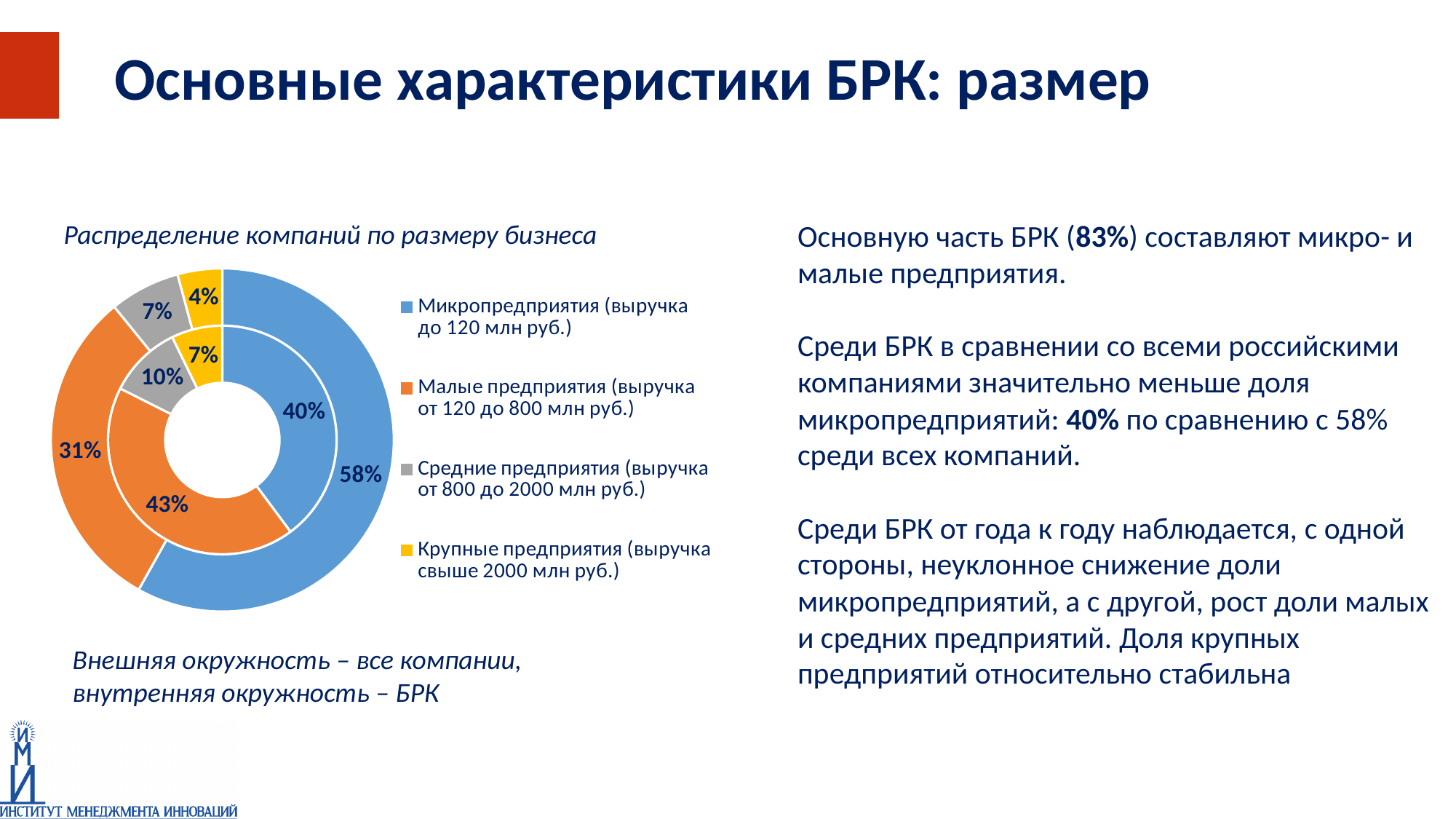
What is the title of the chart? Распределение компаний по размеру бизнеса What is the share of средние предприятия in the inner ring (БРК)? 10% What is the share of микропредприятия in the inner ring (БРК)? 40% What is the share of крупные предприятия in the outer ring (все компании)? 4% How many categories does the legend of the chart list? 4 What type of chart is shown on the slide? Doughnut chart What is the share of малые предприятия in the inner ring (БРК)? 43% Which is larger: the share of малые предприятия in the outer ring or in the inner ring? Inner ring (43%) Which category has the smallest share in the inner ring (БРК)? Крупные предприятия What is the difference between the share of микропредприятия in the outer ring (58%) and in the inner ring (40%)? 18% Which category has the largest share in the outer ring (все компании)? Микропредприятия What is the share of микропредприятия in the outer ring (все компании)? 58%